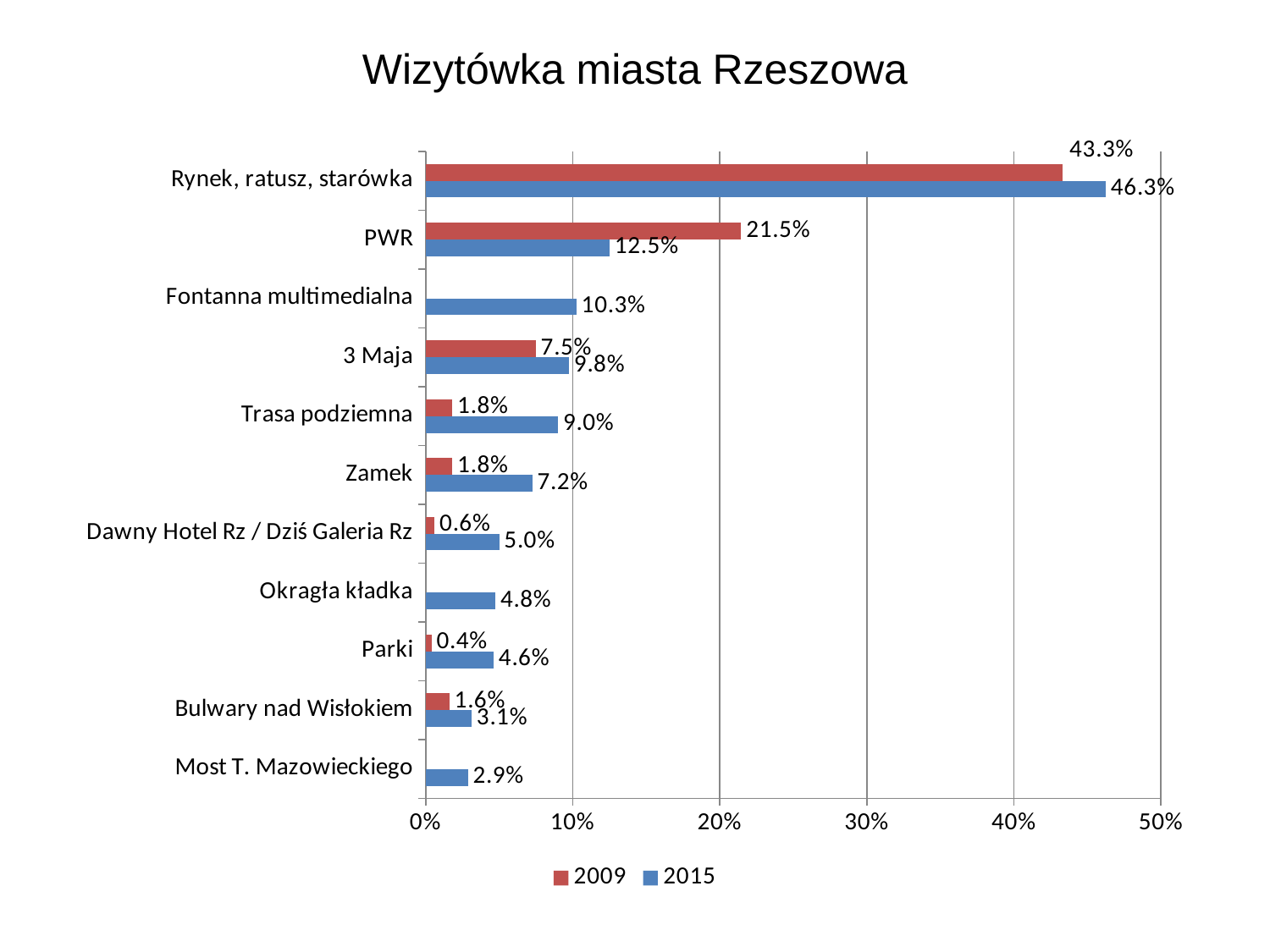
How many series does the legend list? 2 What kind of chart is shown on the slide? bar chart What is the 2009 value for PWR? 21.5% What is the difference between the 2009 and 2015 values for PWR? 9.0% Which category has the lowest 2015 value? Most T. Mazowieckiego What is the title of the chart? Wizytówka miasta Rzeszowa Is the 2009 value for Rynek, ratusz, starówka greater or less than 40%? greater How many categories are shown on the chart? 11 What is the 2015 value for Fontanna multimedialna? 10.3% Which category has the highest 2015 value? Rynek, ratusz, starówka Which is larger for Trasa podziemna, the 2009 value or the 2015 value? 2015 What is the 2015 value for Rynek, ratusz, starówka? 46.3%